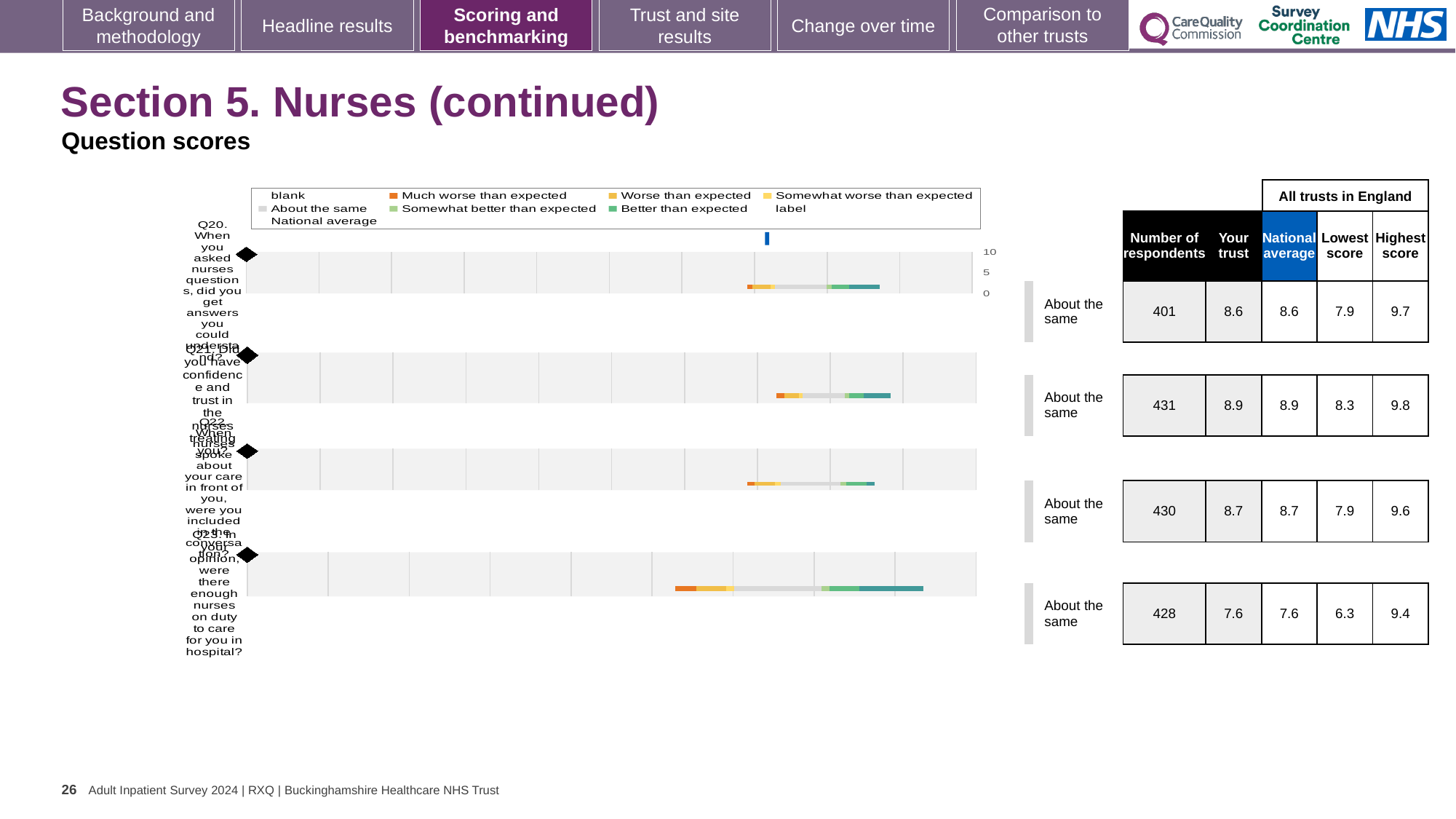
What is the 'Your trust' score for Q20 (When you asked nurses questions, did you get answers you could understand)? 8.6 How many respondents answered Q21? 431 What benchmark category is shown for Q23? About the same Which has the larger 'Your trust' score, Q20 or Q22? Q22 Which question has the lowest 'Your trust' score? Q23 What is the highest score across all trusts in England for Q23? 9.4 What kind of chart is used to show the question scores on this slide? bar chart What is the national average for Q21 (Did you have confidence and trust in the nurses treating you)? 8.9 Which question has the highest 'Your trust' score? Q21 How many questions (categories) are plotted in the chart? 4 What is the difference between the highest score and the lowest score across all trusts in England for Q23? 3.1 What is the 'Your trust' score for Q23 (In your opinion, were there enough nurses on duty to care for you in hospital)? 7.6